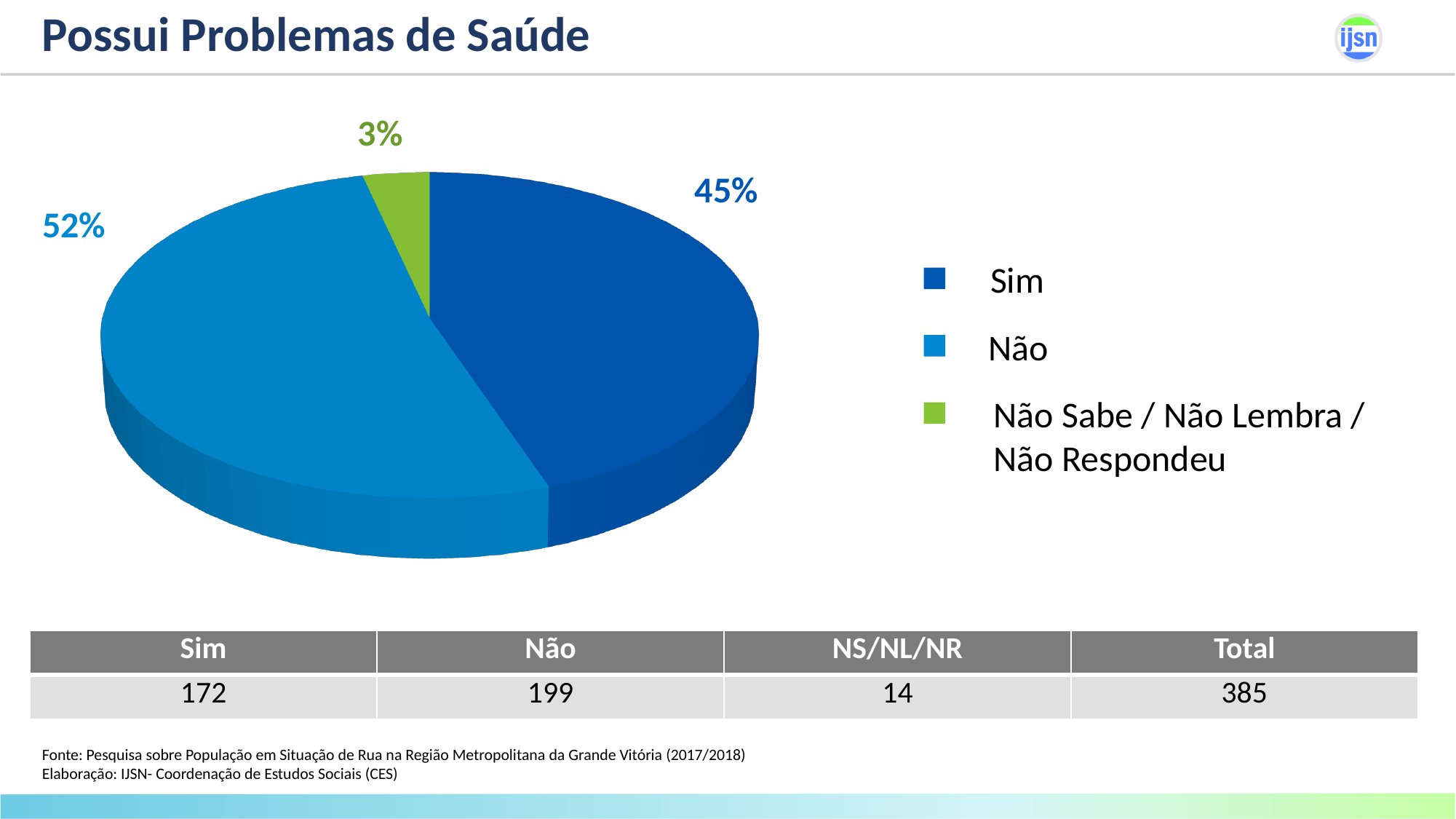
Which category has the largest slice of the pie? Não What is the title of the slide? Possui Problemas de Saúde Which category has the smallest slice of the pie? Não Sabe / Não Lembra / Não Respondeu What share of the pie does the "Não" slice represent? 52% What share of the pie does the "Sim" slice represent? 45% How many entries does the legend list? 3 What share of the pie does the "Não Sabe / Não Lembra / Não Respondeu" slice represent? 3% What colour is the "Não Sabe / Não Lembra / Não Respondeu" slice? Green What kind of chart is shown on the slide? Pie chart Which slice is larger, "Sim" or "Não"? Não How many slices does the pie chart have? 3 What is the difference in percentage points between the "Não" slice and the "Sim" slice? 7 percentage points